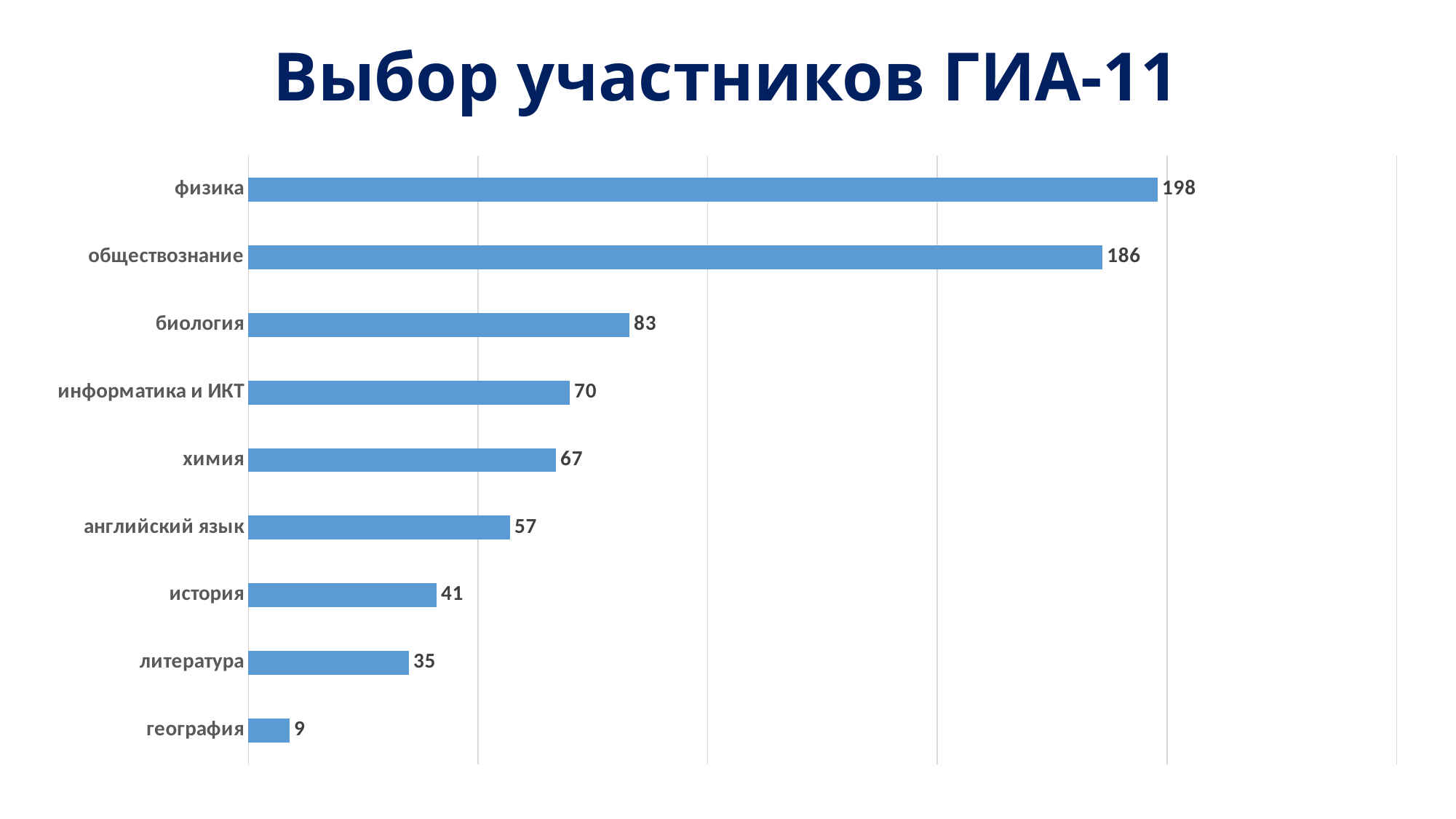
What is the value for английский язык? 57 Which category has the lowest value? география What is the difference between the values for физика and обществознание? 12 Which category has the highest value? физика What is the value for биология? 83 What is the value for география? 9 What kind of chart is shown on the slide? bar chart What is the title of the slide? Выбор участников ГИА-11 Which is larger, the value for история or the value for литература? история What is the difference between the values for информатика и ИКТ and химия? 3 What is the value for физика? 198 How many categories are shown in the chart? 9